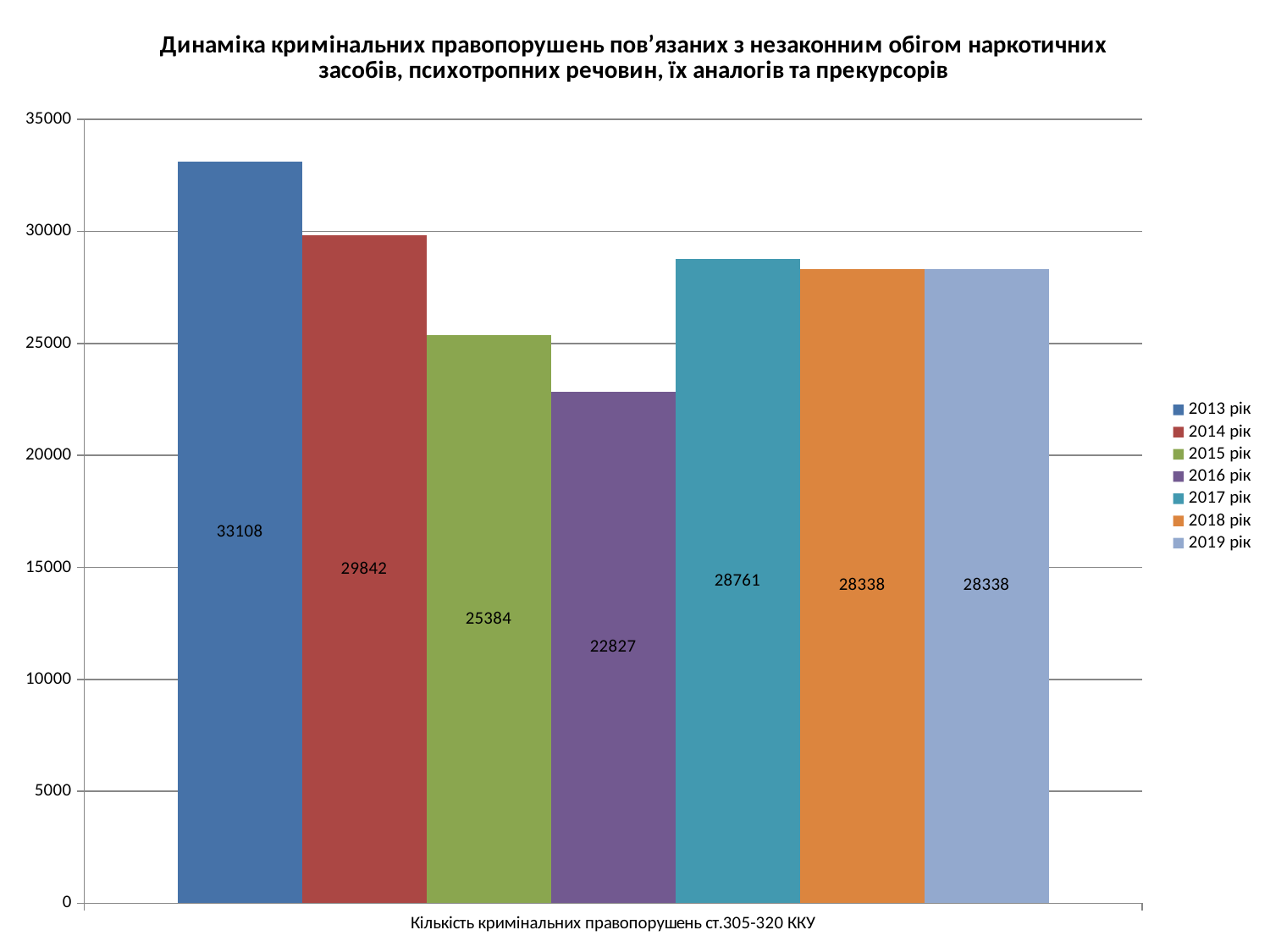
What is the label on the x axis of the chart? Кількість кримінальних правопорушень ст.305-320 ККУ What kind of chart is shown on the slide? bar chart What is the value for 2013 рік? 33108 Is the value for 2014 рік greater or less than 30000? less What is the value for 2016 рік? 22827 Which is larger, the value for 2015 рік or the value for 2016 рік? 2015 рік How many series does the legend list? 7 What is the difference between the values for 2013 рік and 2014 рік? 3266 What is the value for 2017 рік? 28761 Which year has the lowest value? 2016 рік What is the difference between the values for 2017 рік and 2018 рік? 423 Which year has the highest value? 2013 рік